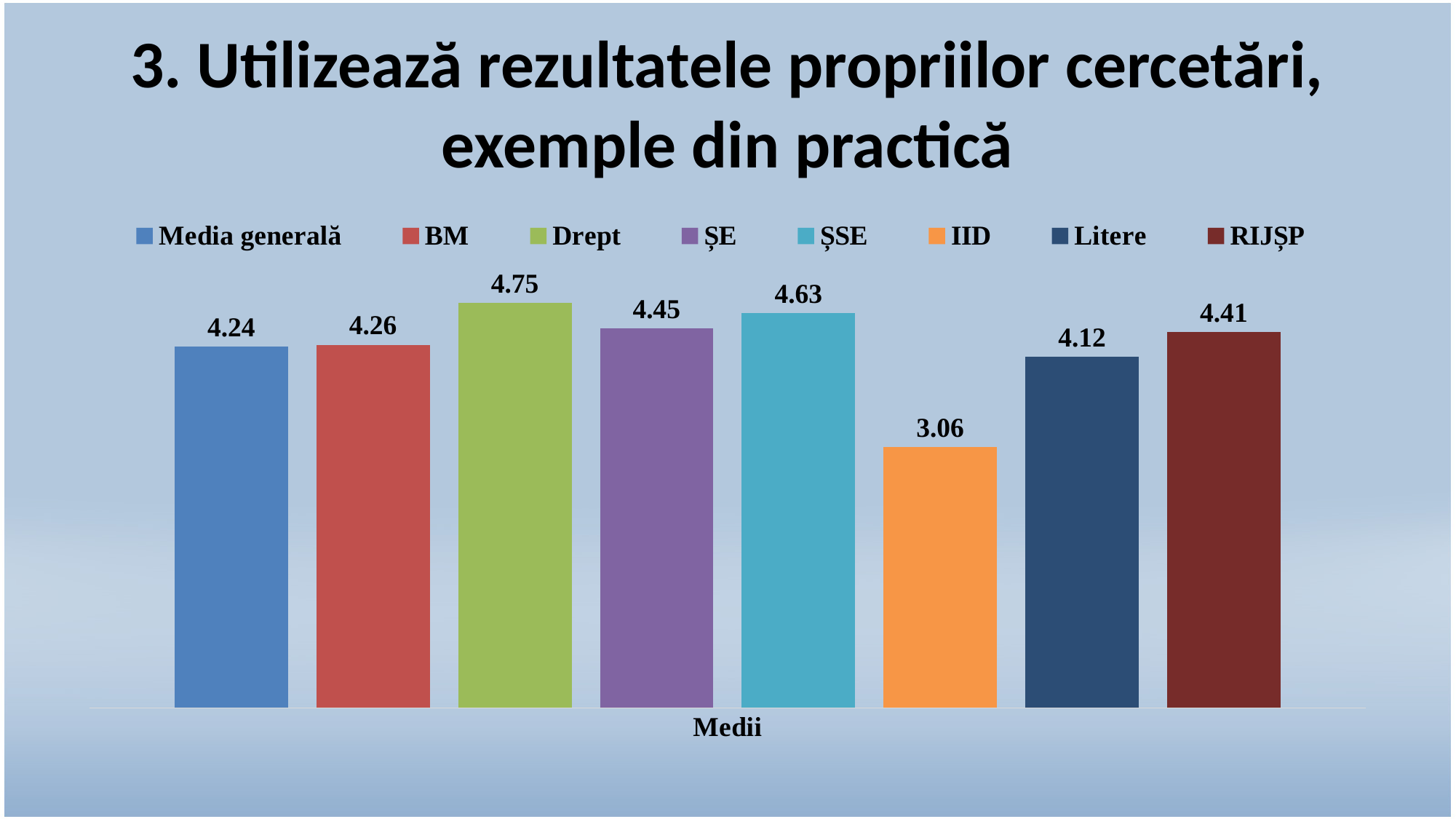
Which series has the highest value? Drept What is the label shown on the x axis of the chart? Medii What is the difference between the values for ȘSE and Litere? 0.51 Which is larger, the value for ȘE or the value for RIJȘP? ȘE What is the value for Media generală? 4.24 What is the value for IID? 3.06 What is the value for Drept? 4.75 What is the value for RIJȘP? 4.41 How many series does the legend list? 8 Which series has the lowest value? IID What kind of chart is shown on the slide? Bar chart What is the difference between the values for Drept and IID? 1.69